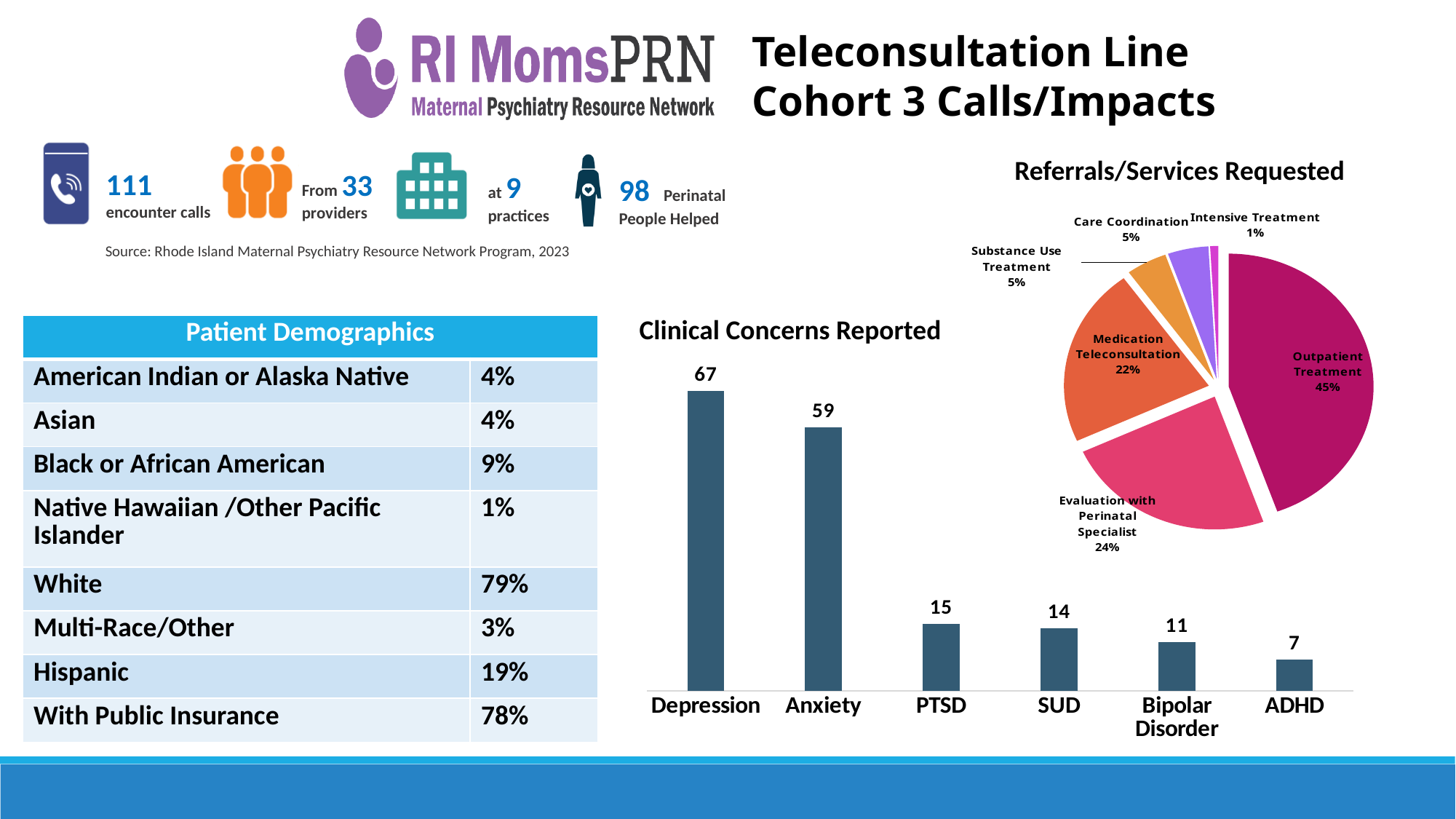
In the Referrals/Services Requested chart, which service has the smallest share? Intensive Treatment In the Referrals/Services Requested chart, what share does Outpatient Treatment have? 45% In the Clinical Concerns Reported chart, what is the value for Depression? 67 What kind of chart is the Clinical Concerns Reported chart? Bar chart In the Clinical Concerns Reported chart, which is larger, the value for PTSD or the value for ADHD? PTSD In the Clinical Concerns Reported chart, what is the value for Bipolar Disorder? 11 In the Clinical Concerns Reported chart, which clinical concern has the highest value? Depression In the Clinical Concerns Reported chart, what is the difference between the values for Depression and Anxiety? 8 What kind of chart is the Referrals/Services Requested chart? Pie chart In the Clinical Concerns Reported chart, which clinical concern has the lowest value? ADHD In the Referrals/Services Requested chart, what share does Medication Teleconsultation have? 22% How many categories are shown in the Clinical Concerns Reported chart? 6